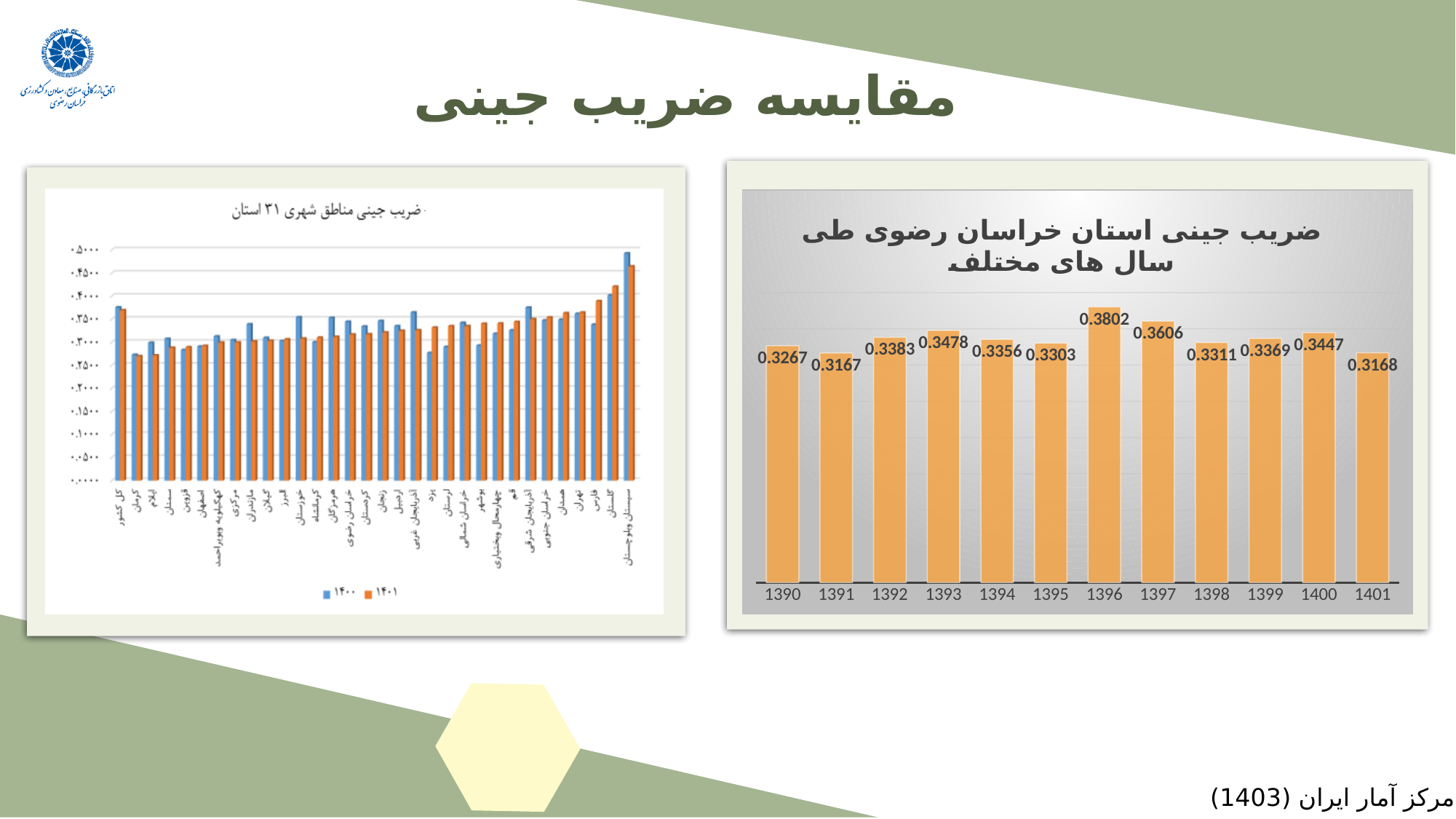
On the right chart (ضریب جینی استان خراسان رضوی طی سال های مختلف), what is the value for 1401? 0.3168 On the right chart (ضریب جینی استان خراسان رضوی طی سال های مختلف), which year has the lowest value? 1391 On the right chart (ضریب جینی استان خراسان رضوی طی سال های مختلف), what kind of chart is it? Bar chart On the left chart (ضریب جینی مناطق شهری ۳۱ استان), what are the two series named in the legend? ۱۴۰۰ and ۱۴۰۱ On the left chart (ضریب جینی مناطق شهری ۳۱ استان), which province has the highest values? سیستان و بلوچستان On the left chart (ضریب جینی مناطق شهری ۳۱ استان), how many series does the legend list? 2 On the right chart (ضریب جینی استان خراسان رضوی طی سال های مختلف), which is larger, the value for 1393 or the value for 1394? 1393 On the right chart (ضریب جینی استان خراسان رضوی طی سال های مختلف), does the value rise or fall from 1400 to 1401? Fall On the right chart (ضریب جینی استان خراسان رضوی طی سال های مختلف), which year has the highest value? 1396 On the right chart (ضریب جینی استان خراسان رضوی طی سال های مختلف), how many years are shown? 12 On the right chart (ضریب جینی استان خراسان رضوی طی سال های مختلف), what is the value for 1396? 0.3802 On the right chart (ضریب جینی استان خراسان رضوی طی سال های مختلف), what is the difference between the values for 1397 and 1398? 0.0295